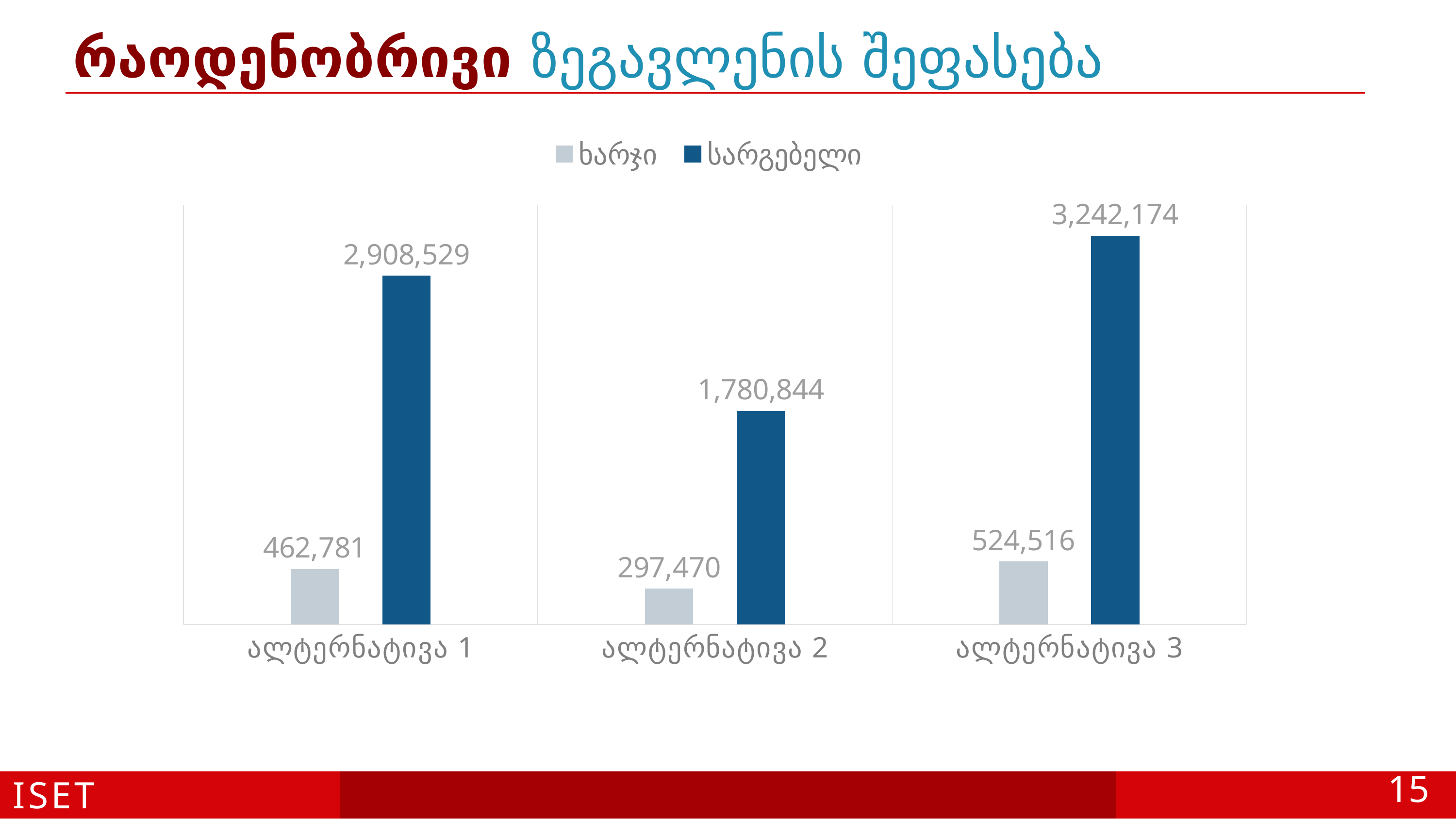
What is the value of ხარჯი for ალტერნატივა 2? 297,470 What is the difference between the სარგებელი values of ალტერნატივა 3 and ალტერნატივა 1? 333,645 What is the value of სარგებელი for ალტერნატივა 1? 2,908,529 What is the value of სარგებელი for ალტერნატივა 3? 3,242,174 Which alternative has the lowest ხარჯი value? ალტერნატივა 2 Which is larger for ალტერნატივა 2: ხარჯი or სარგებელი? სარგებელი What kind of chart is shown on the slide? Bar chart Which alternative has the highest სარგებელი value? ალტერნატივა 3 What is the difference between the ხარჯი values of ალტერნატივა 3 and ალტერნატივა 2? 227,046 What is the value of ხარჯი for ალტერნატივა 3? 524,516 How many series does the legend list? 2 How many alternatives (categories) are shown on the x axis? 3